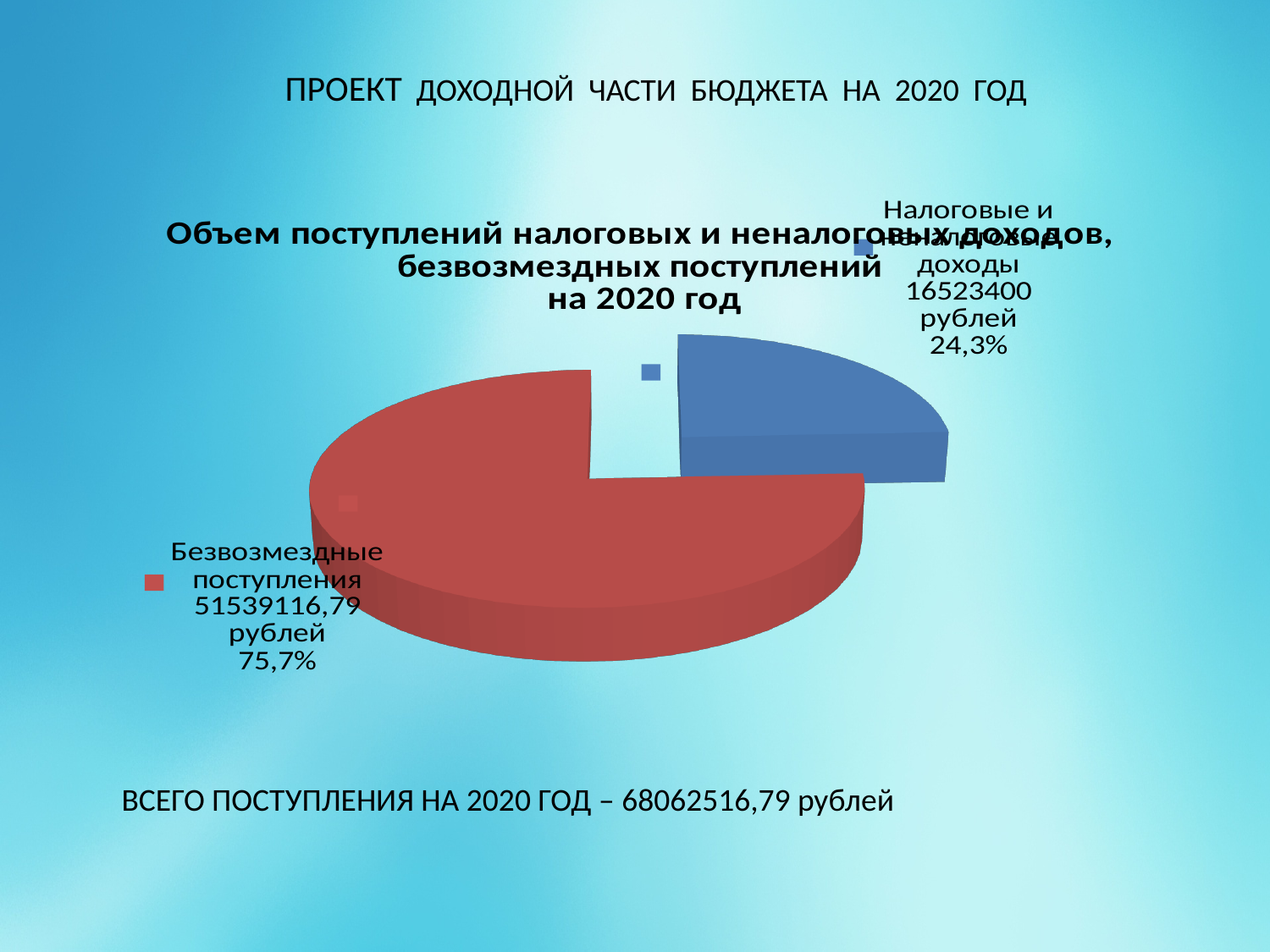
What colour is the slice for "Налоговые и неналоговые доходы"? blue Which is larger: the share for "Безвозмездные поступления" or the share for "Налоговые и неналоговые доходы"? Безвозмездные поступления What is the title of the pie chart? Объем поступлений налоговых и неналоговых доходов, безвозмездных поступлений на 2020 год What is the value in rubles shown for "Безвозмездные поступления"? 51539116,79 рублей Which slice of the pie chart is the smallest? Налоговые и неналоговые доходы What is the difference in percentage points between the shares of "Безвозмездные поступления" and "Налоговые и неналоговые доходы"? 51,4 What share of the pie does "Налоговые и неналоговые доходы" represent? 24,3% Which slice of the pie chart is the largest? Безвозмездные поступления What kind of chart is shown on the slide? pie chart What share of the pie does "Безвозмездные поступления" represent? 75,7% How many slices does the pie chart have? 2 What is the value in rubles shown for "Налоговые и неналоговые доходы"? 16523400 рублей